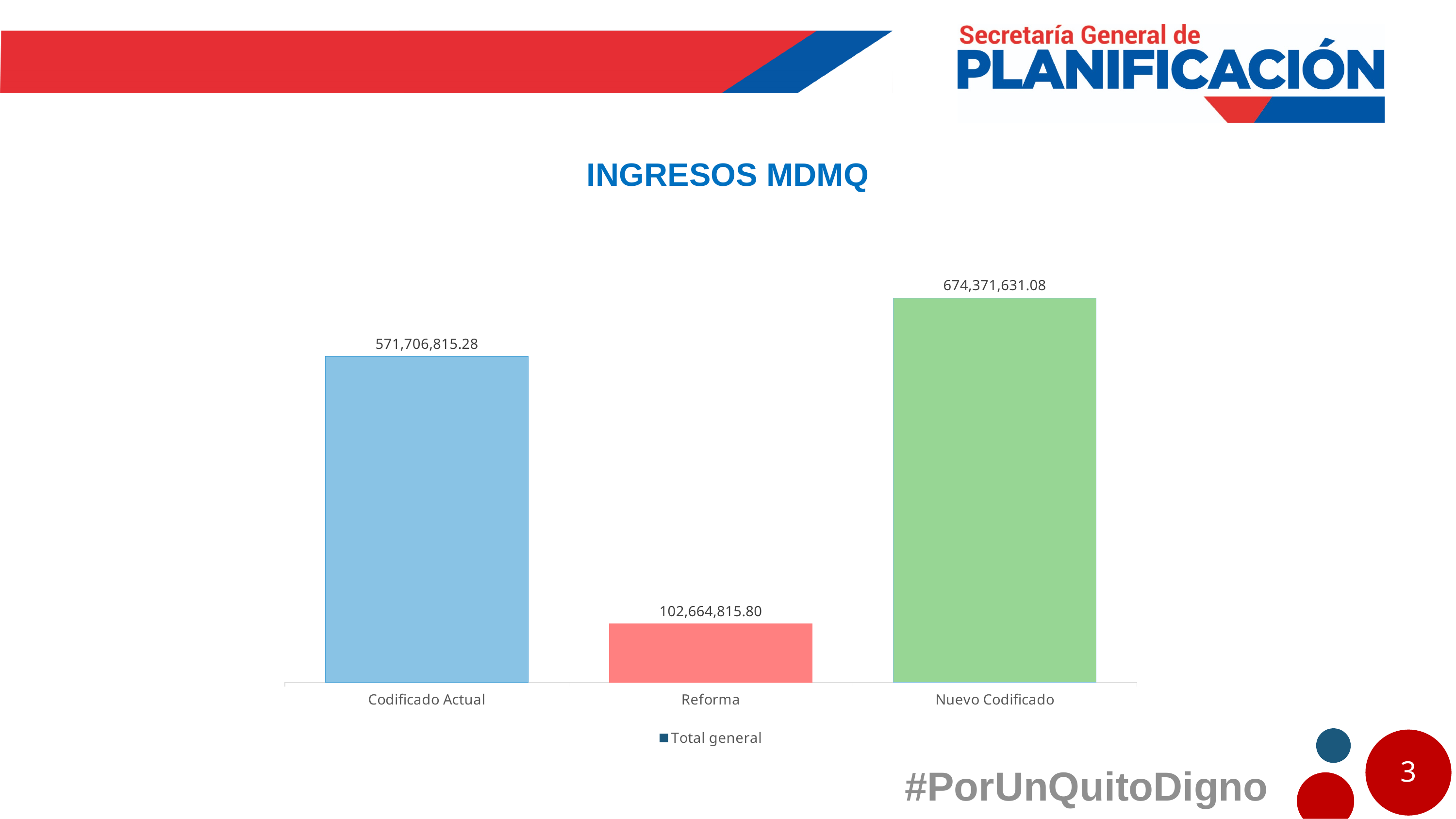
What is the difference between the values for Codificado Actual and Reforma? 469,041,999.48 What is the title of the chart? INGRESOS MDMQ What is the value for Nuevo Codificado? 674,371,631.08 How many categories are shown on the x axis? 3 What is the value for Codificado Actual? 571,706,815.28 Which category has the highest value? Nuevo Codificado Which category has the lowest value? Reforma What kind of chart is shown on the slide? Bar chart What is the difference between the values for Nuevo Codificado and Codificado Actual? 102,664,815.80 What is the value for Reforma? 102,664,815.80 Which is larger, the value for Codificado Actual or the value for Reforma? Codificado Actual How many series does the legend list? 1